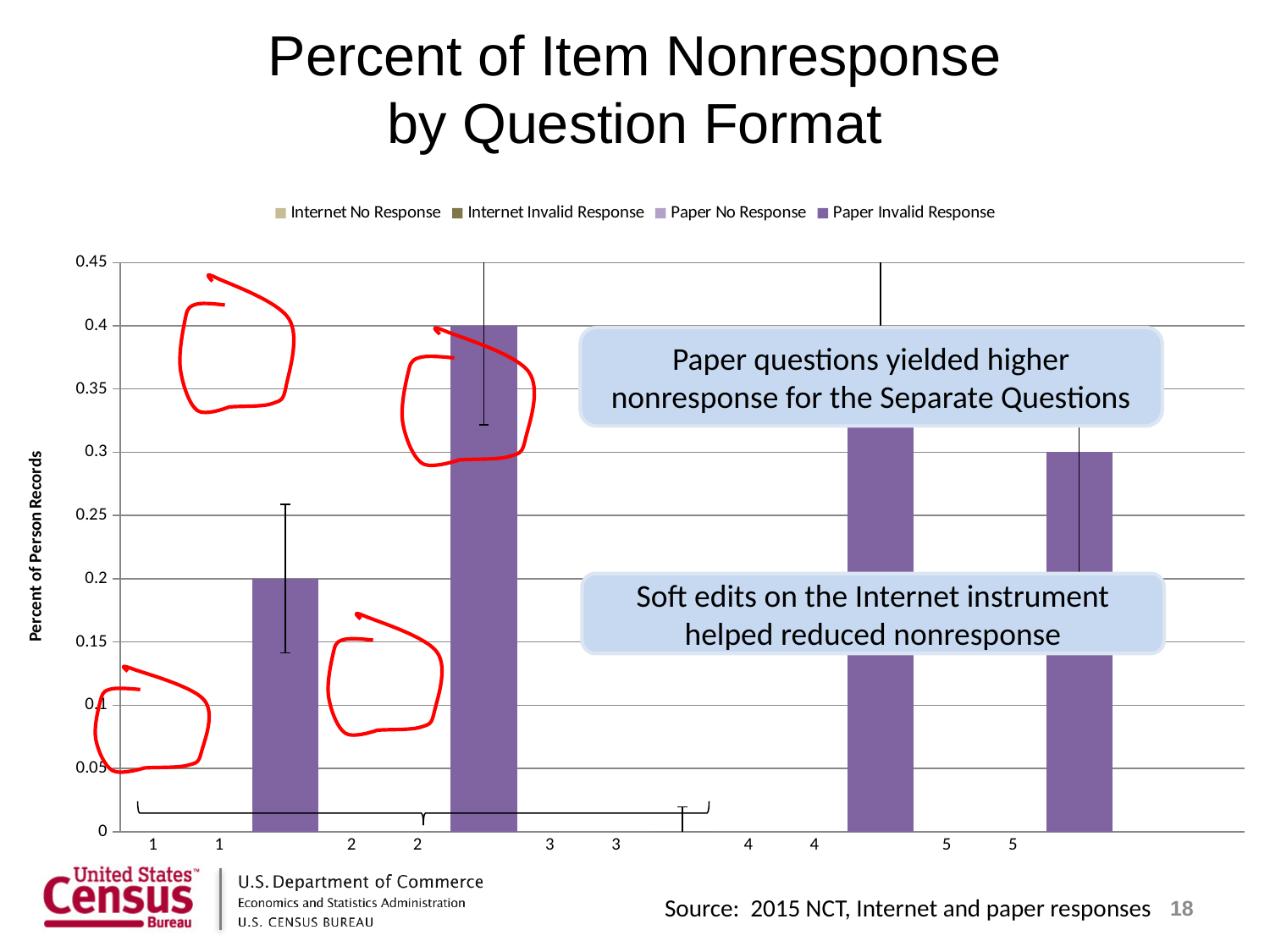
What is the value of the purple bar at category 5? 0.3 How many purple bars are plotted on the chart? 4 What is the value of the purple bar at category 1? 0.2 What kind of chart is shown on the slide? bar chart What is the difference between the purple bar at category 2 and the purple bar at category 1? 0.2 Which category has the shortest purple bar? 1 Is the value of the purple bar at category 4 greater or less than 0.3? greater How many series does the chart legend list? 4 What is the value of the purple bar at category 2? 0.4 What is the label on the vertical axis of the chart? Percent of Person Records Which is larger, the purple bar at category 2 or the purple bar at category 5? category 2